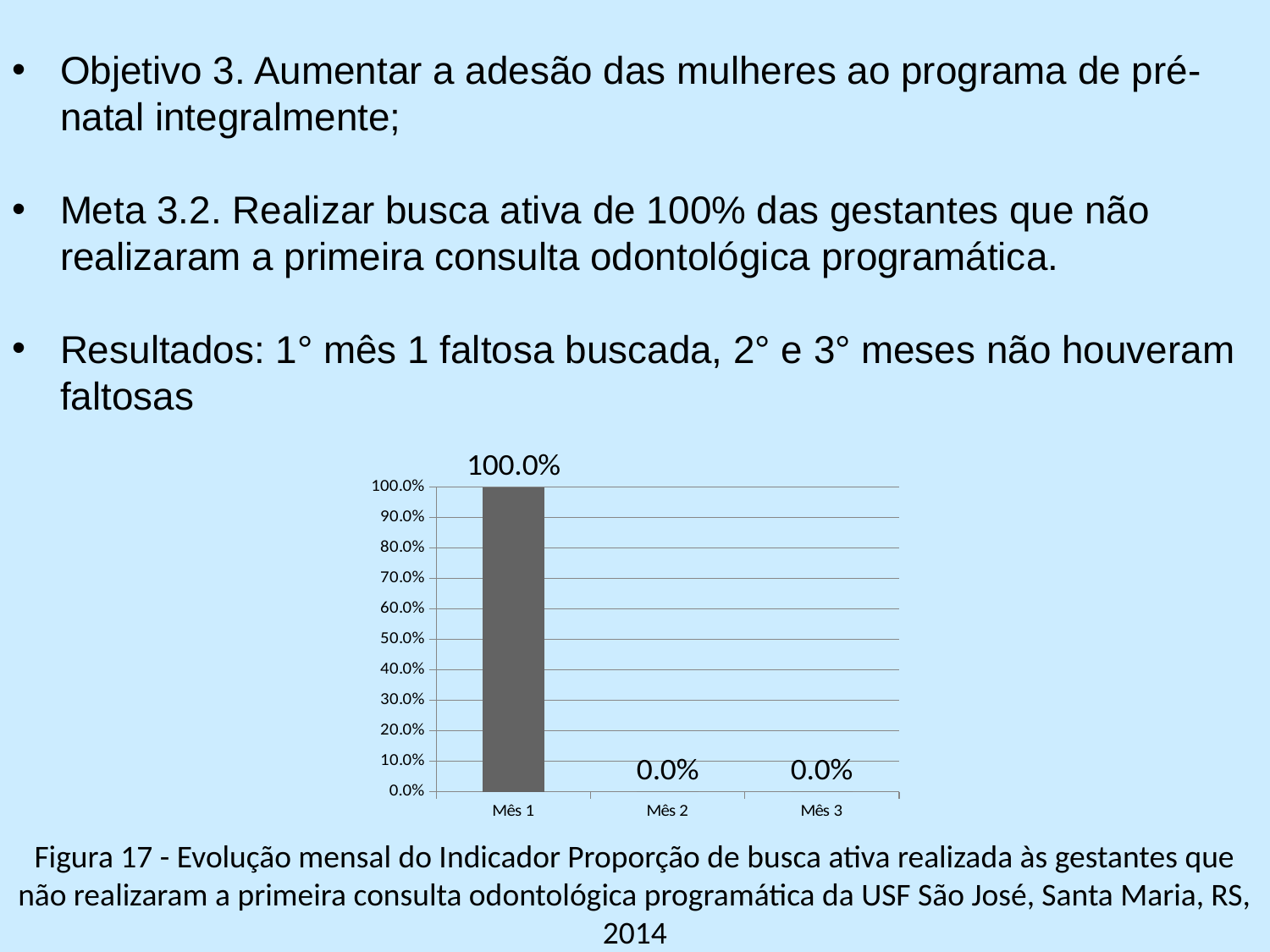
Which month has the highest value? Mês 1 What is the value for Mês 2? 0.0% Which is larger, the value for Mês 1 or the value for Mês 3? Mês 1 What figure number is given in the caption below the chart? Figura 17 How many months are shown on the x axis? 3 What is the difference between the values for Mês 1 and Mês 2? 100.0% What kind of chart is shown on the slide? bar chart What is the value for Mês 1? 100.0% Is the value for Mês 1 greater or less than 50.0%? greater Do the values rise or fall from Mês 1 to Mês 3? fall What is the value for Mês 3? 0.0% What is the highest tick value shown on the y axis? 100.0%